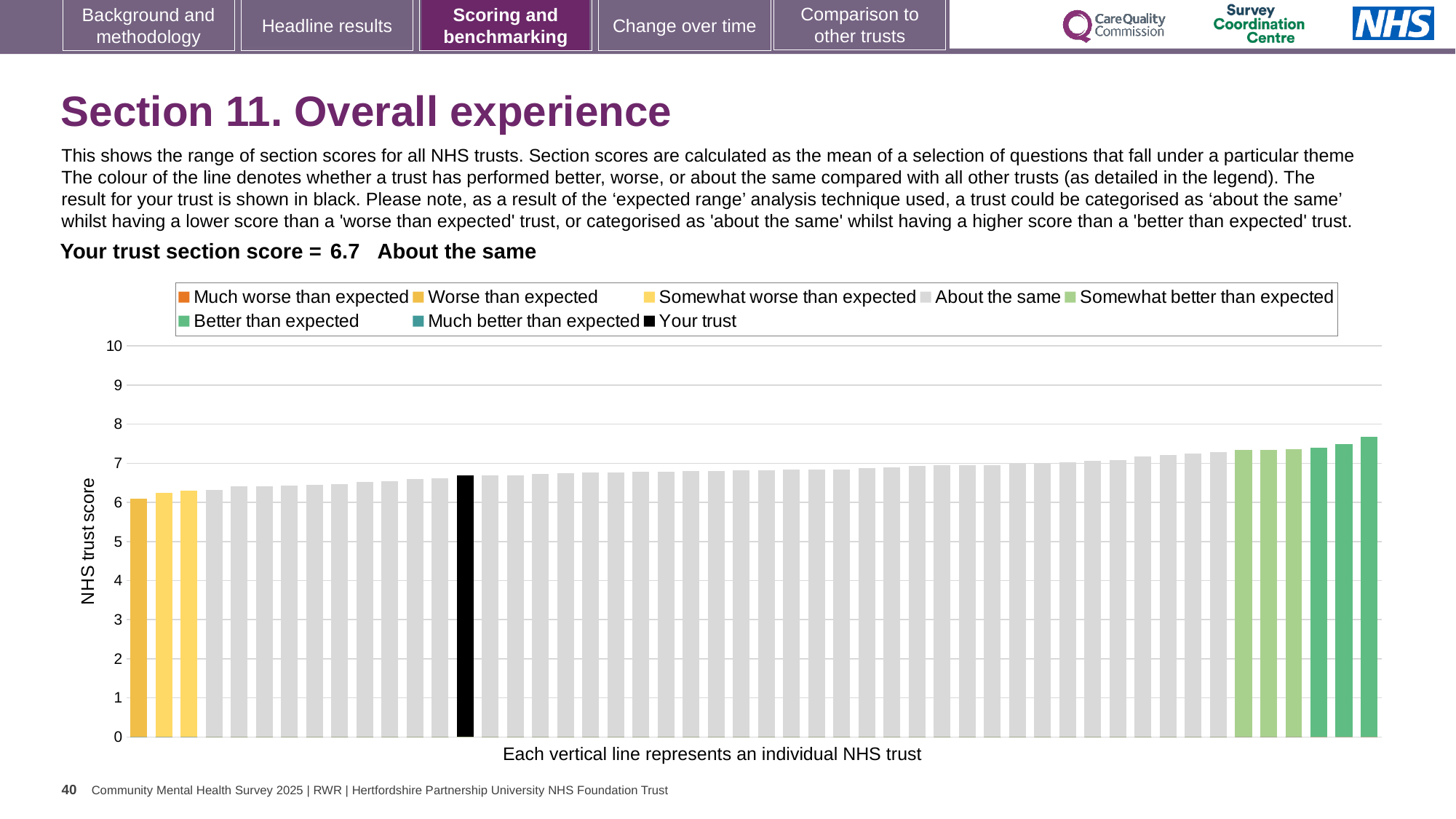
What is the section score for your trust shown on the slide? 6.7 Is the value of the shortest bar (leftmost) greater or less than 5? greater Which bar is taller, the leftmost bar or the rightmost bar? the rightmost bar Is the value of the shortest bar (leftmost) greater or less than 7? less How many entries does the chart legend list? 8 What kind of chart is shown on the slide? bar chart Is the value of the tallest bar (rightmost) greater or less than 7? greater What is the label on the vertical axis of the chart? NHS trust score Do the bar heights rise or fall moving from left to right along the chart? rise Which performance category is your trust placed in for this section? About the same